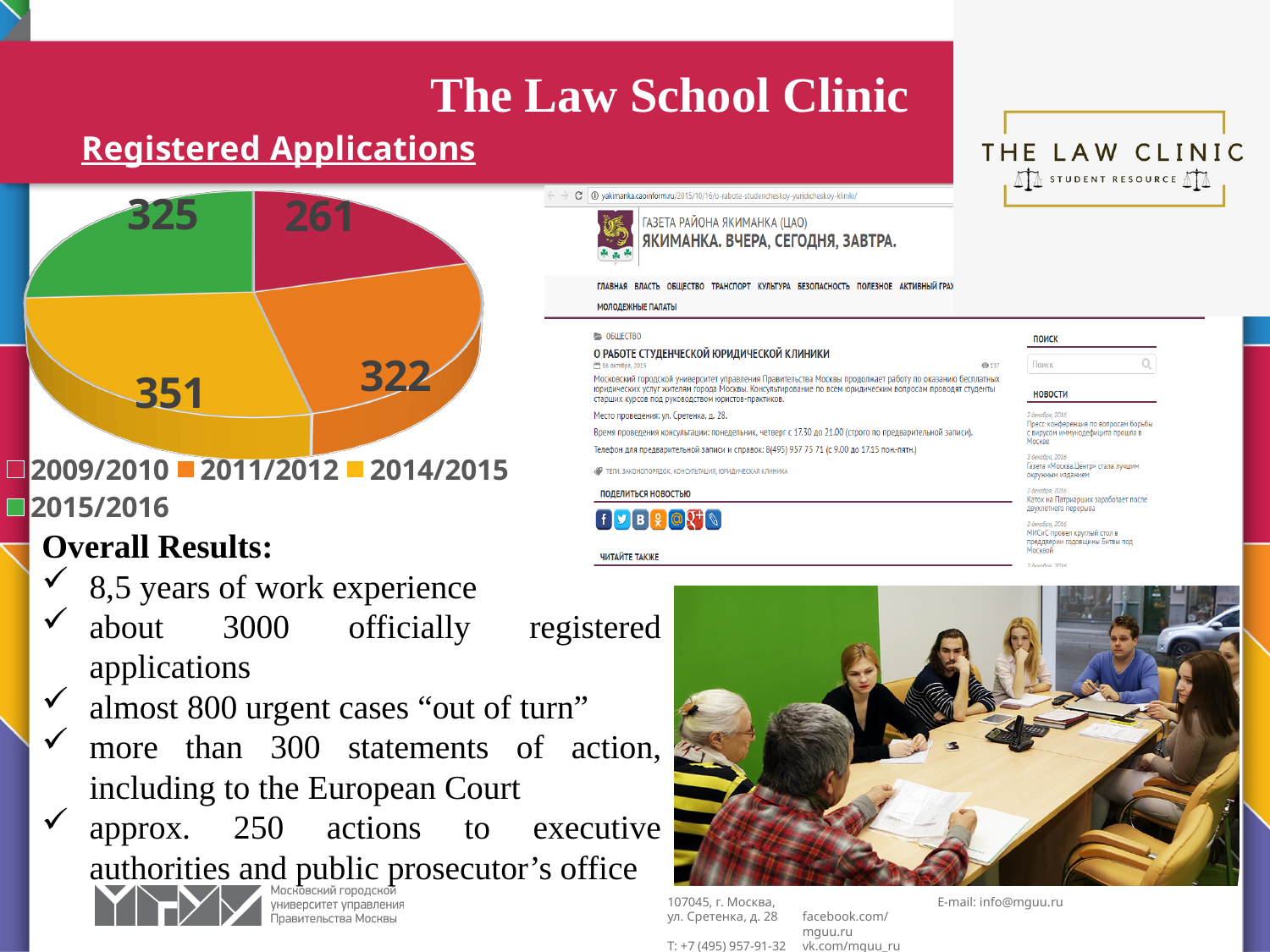
Which period had more registered applications, 2014/2015 or 2015/2016? 2014/2015 How many entries does the legend of the Registered Applications chart list? 4 What is the difference between the registered applications in 2014/2015 and 2009/2010? 90 Which period has the highest number of registered applications? 2014/2015 Which period has the lowest number of registered applications? 2009/2010 What is the number of registered applications for 2015/2016? 325 What is the number of registered applications for 2011/2012? 322 What is the total number of registered applications across all four periods shown in the pie chart? 1259 What type of chart is used to show Registered Applications? pie chart What is the number of registered applications for 2009/2010? 261 How many slices does the Registered Applications pie chart have? 4 What is the number of registered applications for 2014/2015? 351